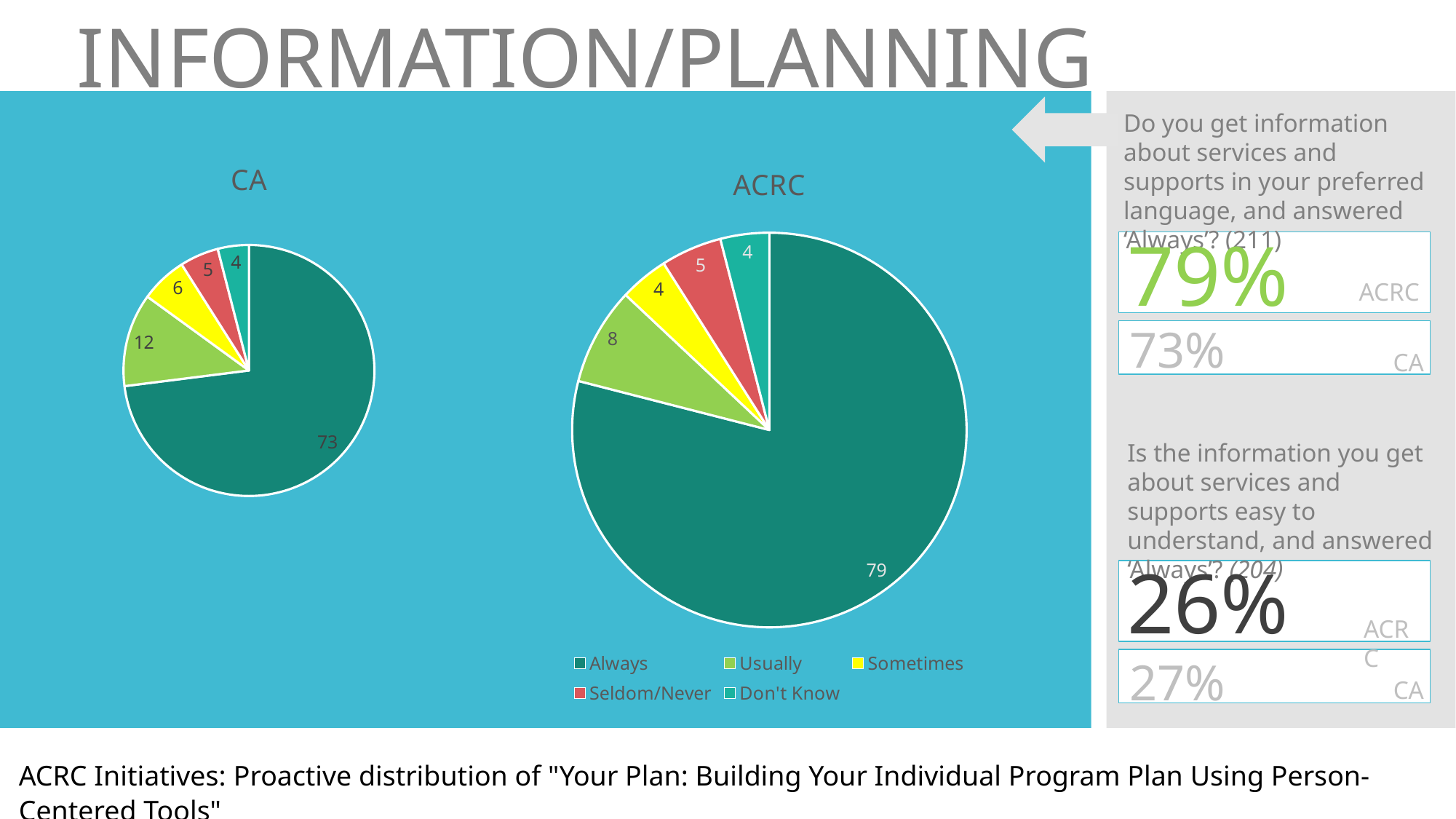
In the CA pie chart, what is the value for Usually? 12 How many categories does the legend list for the pie charts? 5 In the ACRC pie chart, what is the value for Seldom/Never? 5 In the CA pie chart, what is the value for Always? 73 In the ACRC pie chart, which category has the largest slice? Always In the CA pie chart, which category has the smallest slice? Don't Know What type of chart is used for CA and ACRC on this slide? Pie chart In the CA pie chart, which category has the largest slice? Always What is the difference between the Always values in the ACRC and CA pie charts? 6 In the CA pie chart, what is the difference between the Usually and Sometimes values? 6 In the ACRC pie chart, what is the value for Always? 79 Which is larger: the Usually value in the CA pie chart or the Usually value in the ACRC pie chart? CA